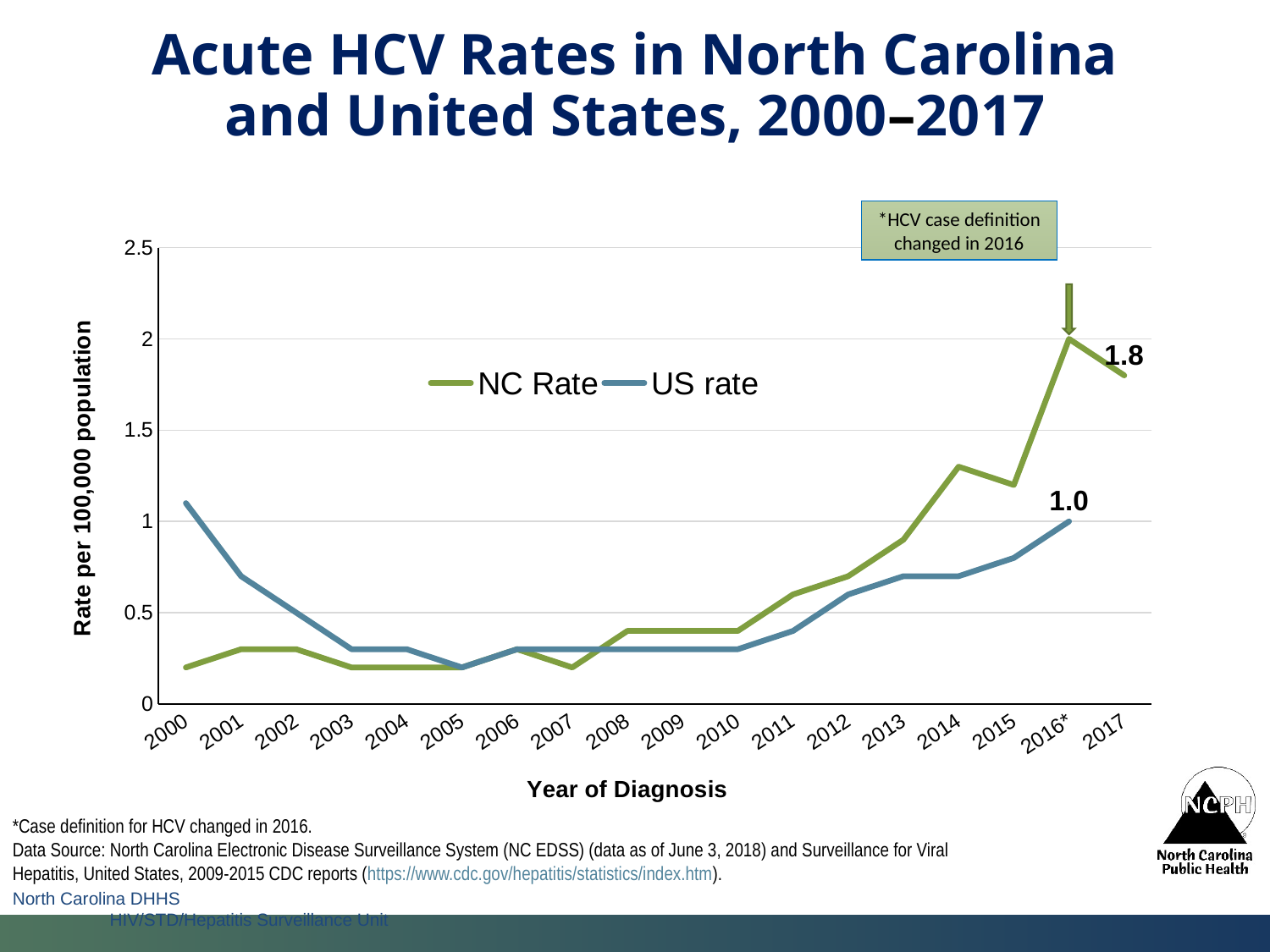
In 2000, which series has the higher value, NC Rate or US rate? US rate What is the US rate for 2016*? 1.0 Is the NC Rate for 2014 greater or less than 1? greater Is the US rate for 2000 greater or less than 0.5? greater What is the NC Rate for 2017? 1.8 What kind of chart is shown on the slide? line chart Does the US rate rise or fall from 2000 to 2005? fall How many years are shown on the x axis? 18 Is the NC Rate for 2003 greater or less than 0.5? less In 2016*, which series has the higher value, NC Rate or US rate? NC Rate How many series does the legend list? 2 In which year is the NC Rate highest? 2016*